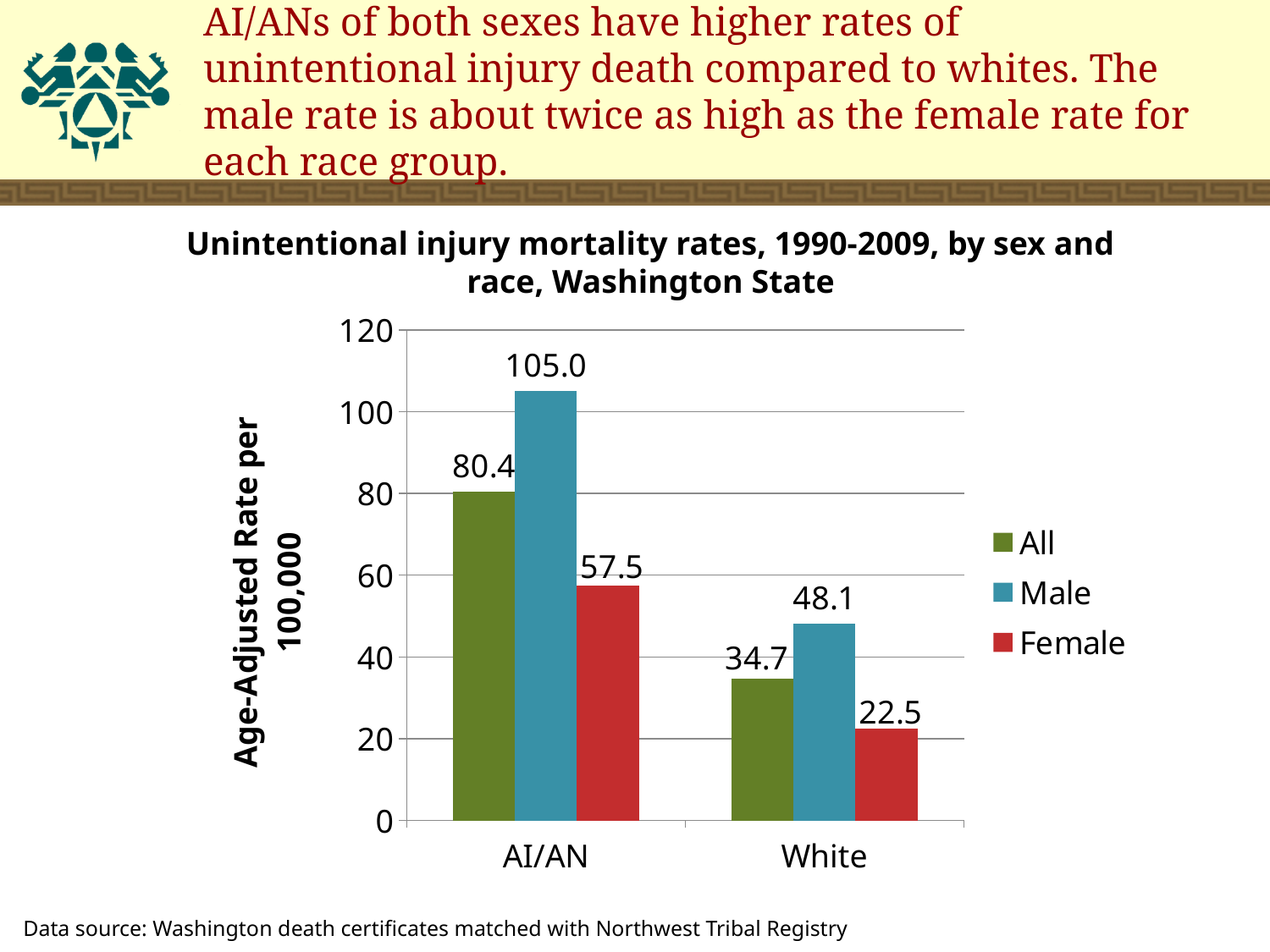
Which race group has the highest Male rate? AI/AN What is the Female rate for White? 22.5 How many series does the legend list? 3 What is the Male rate for White? 48.1 Which series has the lowest value for White? Female What is the difference between the Male and Female rates for AI/AN? 47.5 What is the Male unintentional injury mortality rate for AI/AN? 105.0 How many race groups are shown on the x axis? 2 What is the All rate for AI/AN? 80.4 Which is larger, the Female rate for AI/AN or the Male rate for White? Female rate for AI/AN What kind of chart is shown? Bar chart What is the difference between the All rates for AI/AN and White? 45.7